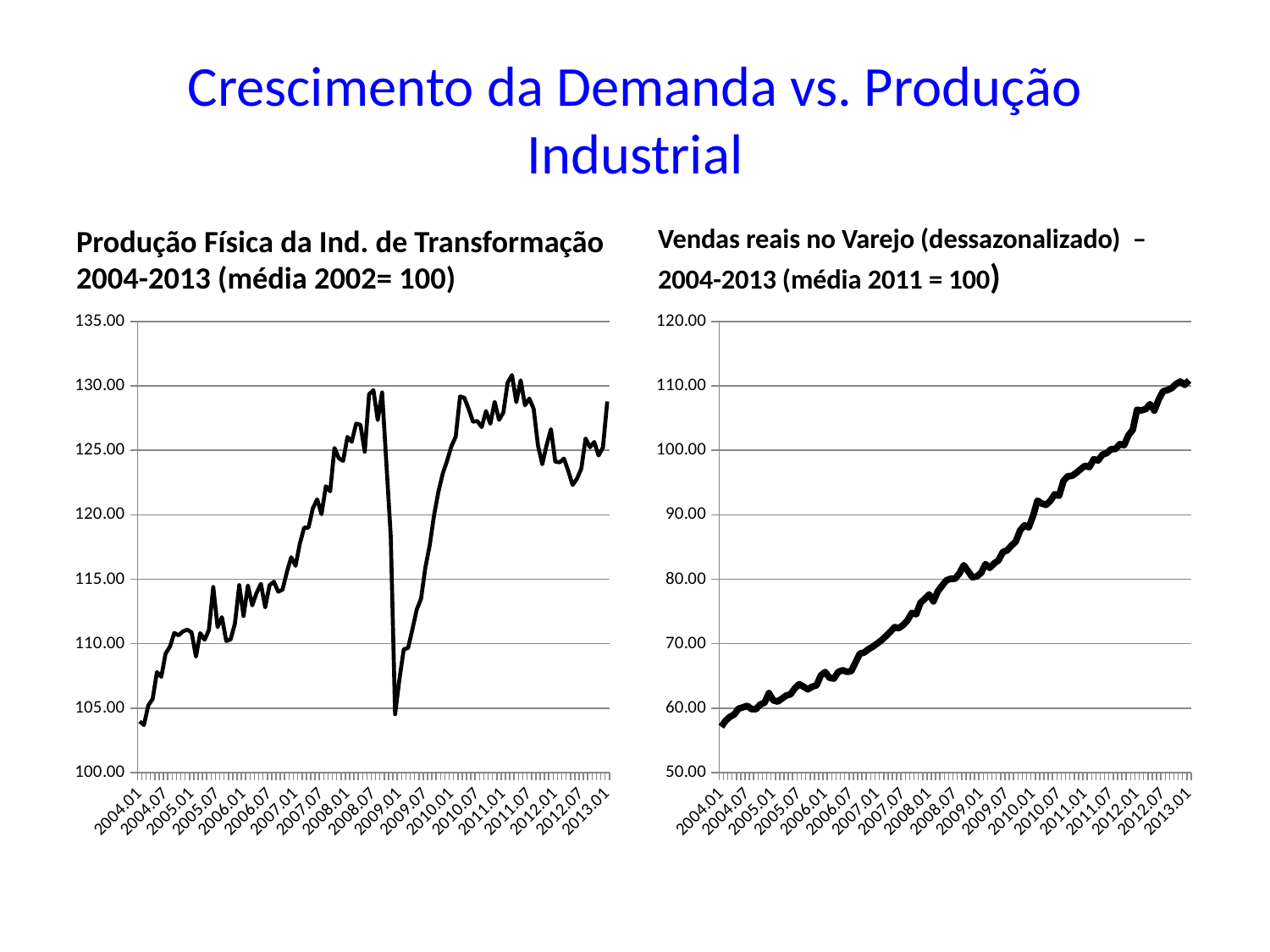
What kind of chart is the right chart, 'Vendas reais no Varejo (dessazonalizado)'? line chart In the left chart, 'Produção Física da Ind. de Transformação', which is larger: the value at 2004.01 or the value at 2013.01? 2013.01 In the left chart, 'Produção Física da Ind. de Transformação', is the value at 2009.01 greater or less than 110? less In the right chart, 'Vendas reais no Varejo', is the value at 2013.01 greater or less than 100? greater In the right chart, 'Vendas reais no Varejo', is the value at 2008.01 greater or less than 80? less What kind of chart is the left chart, 'Produção Física da Ind. de Transformação'? line chart In the right chart, 'Vendas reais no Varejo', do the values generally rise or fall from 2004.01 to 2013.01? rise What is the base period stated in the title of the right chart, 'Vendas reais no Varejo'? média 2011 = 100